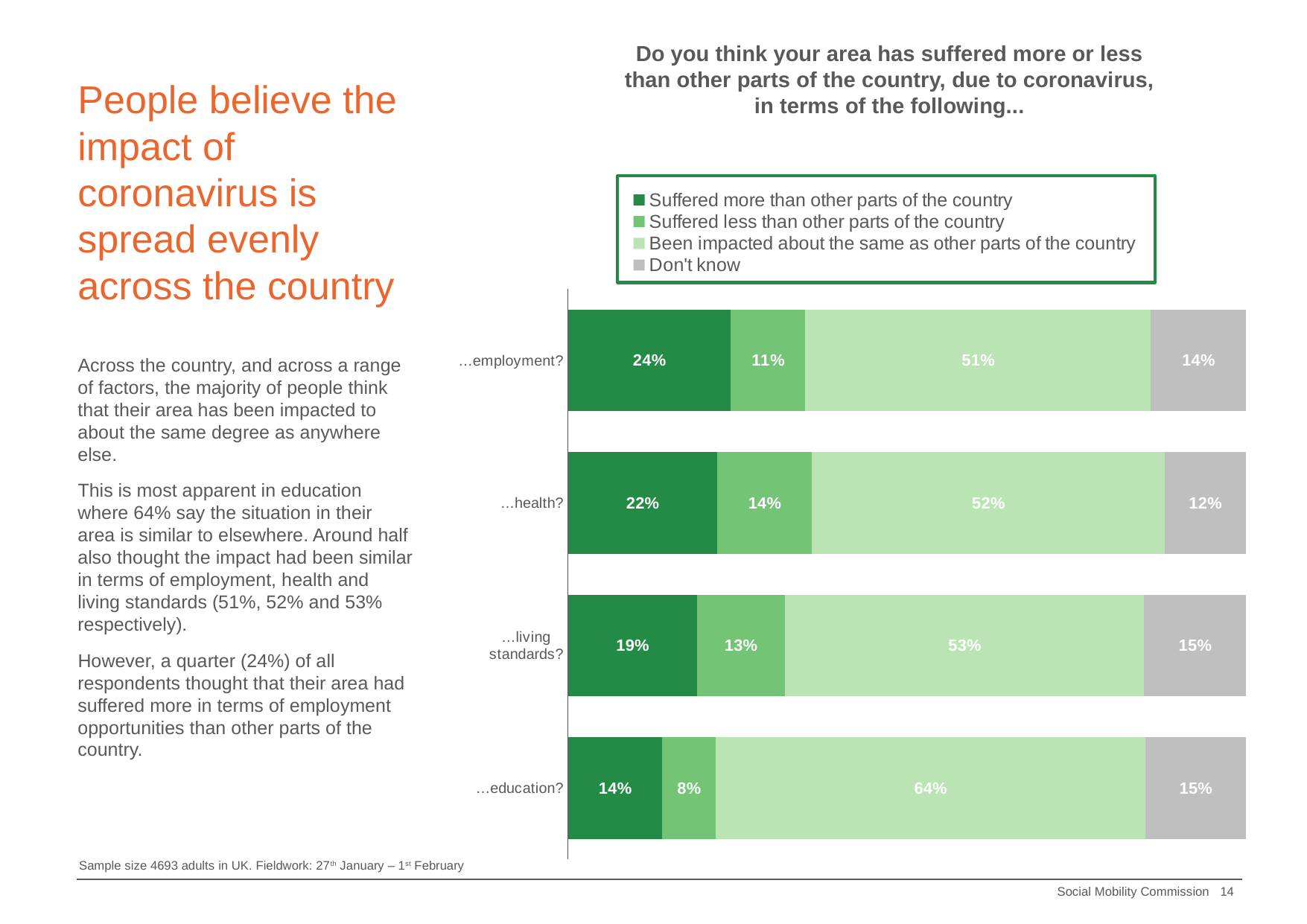
What kind of chart is shown on the slide? Stacked bar chart How many series does the legend list? 4 What percentage said their area had suffered less than other parts of the country in terms of living standards? 13% What is the difference between the 'Suffered more than other parts of the country' percentages for employment and education? 10 percentage points What percentage of respondents said their area had suffered more than other parts of the country in terms of employment? 24% What percentage of respondents said their area had been impacted about the same as other parts of the country in terms of education? 64% Which category has the lowest share of respondents saying their area had suffered more than other parts of the country? …education? How many categories are shown on the chart? 4 What is the total of the segments in the health bar? 100% Which is larger: the 'Suffered less than other parts of the country' share for health or for employment? health What percentage answered 'Don't know' for health? 12% Which category has the highest share of respondents saying their area had been impacted about the same as other parts of the country? …education?